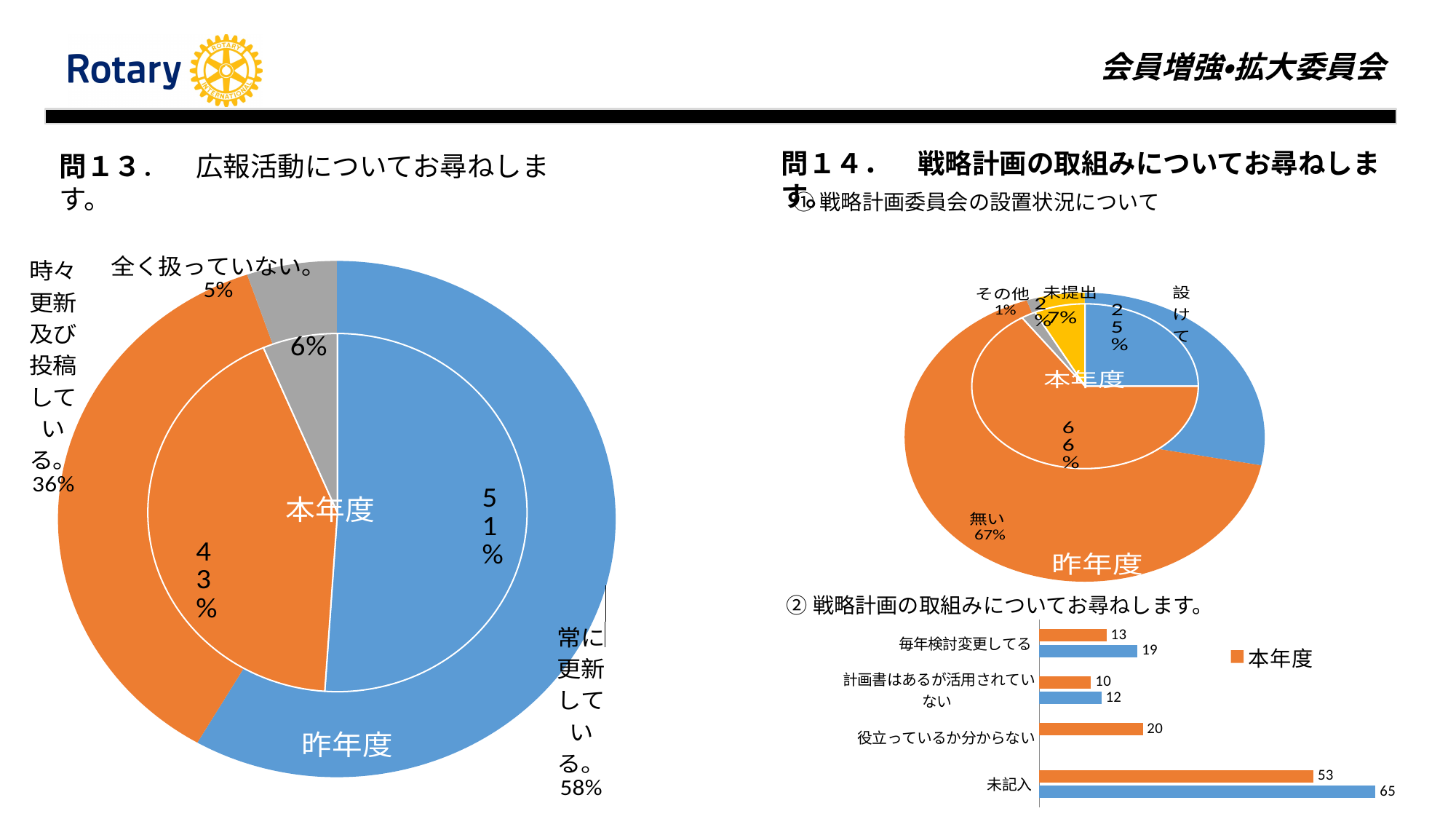
What kind of chart is the 問14② chart at the bottom right of the slide? Bar chart In the 問13 pie chart on the left, what percentage of the 昨年度 (outer ring) is 時々更新及び投稿している? 36% In the 問14② bar chart at the bottom right, what is the 本年度 (orange) value for 未記入? 53 In the 問13 pie chart on the left, what percentage of the 昨年度 (outer ring) is 全く扱っていない? 5% In the 問13 pie chart on the left, what is the difference between the 昨年度 share (58%) and the 本年度 share (51%) for 常に更新している? 7% In the 問13 pie chart on the left, which category has the largest share in the 昨年度 outer ring? 常に更新している In the 問14① pie chart on the right, which category has the smallest share in the 昨年度 outer ring? その他 In the 問14② bar chart at the bottom right, what is the difference between the two bars for 毎年検討変更してる (19 and 13)? 6 In the 問13 pie chart on the left, what percentage of the 昨年度 (outer ring) is 常に更新している? 58% In the 問14① pie chart on the right, what percentage of the 昨年度 (outer ring) is 無い? 67% In the 問14② bar chart at the bottom right, what is the 本年度 (orange) value for 役立っているか分からない? 20